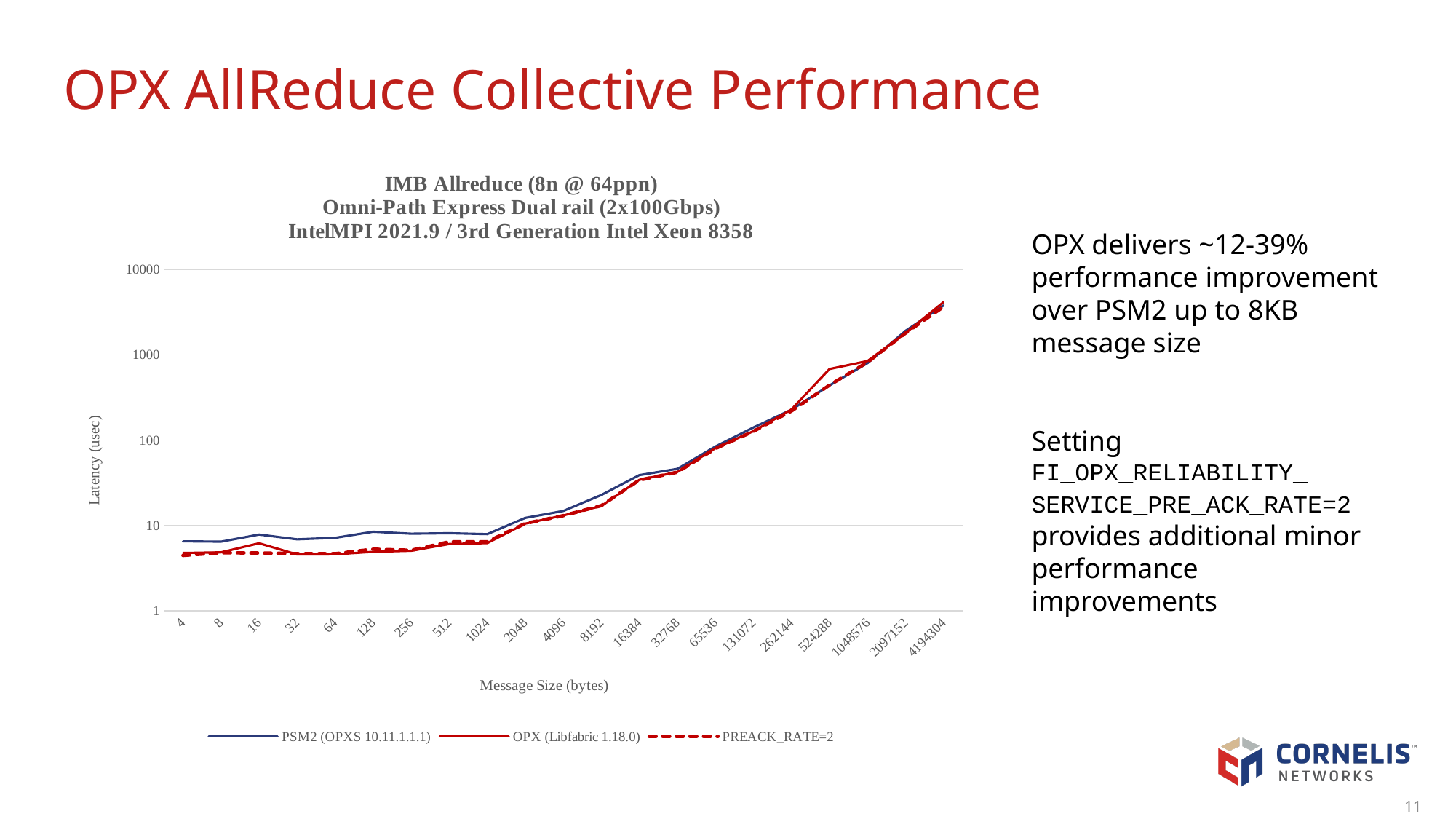
What is the label of the chart's y axis? Latency (usec) At message size 16, which series has the higher latency: PSM2 (OPXS 10.11.1.1.1) or PREACK_RATE=2? PSM2 (OPXS 10.11.1.1.1) How many message sizes are plotted along the x axis? 21 What kind of chart is shown on the slide? line chart Is the PSM2 (OPXS 10.11.1.1.1) latency at message size 65536 greater or less than 10 usec? greater Does latency generally rise or fall as message size increases along the x axis? rise How many series does the chart legend list? 3 Which series is drawn with a dashed line in the chart? PREACK_RATE=2 Is the OPX (Libfabric 1.18.0) latency at message size 16384 greater or less than 100 usec? less Is the PSM2 (OPXS 10.11.1.1.1) latency at message size 4 greater or less than 10 usec? less At message size 524288, which series has the higher latency: OPX (Libfabric 1.18.0) or PREACK_RATE=2? OPX (Libfabric 1.18.0)